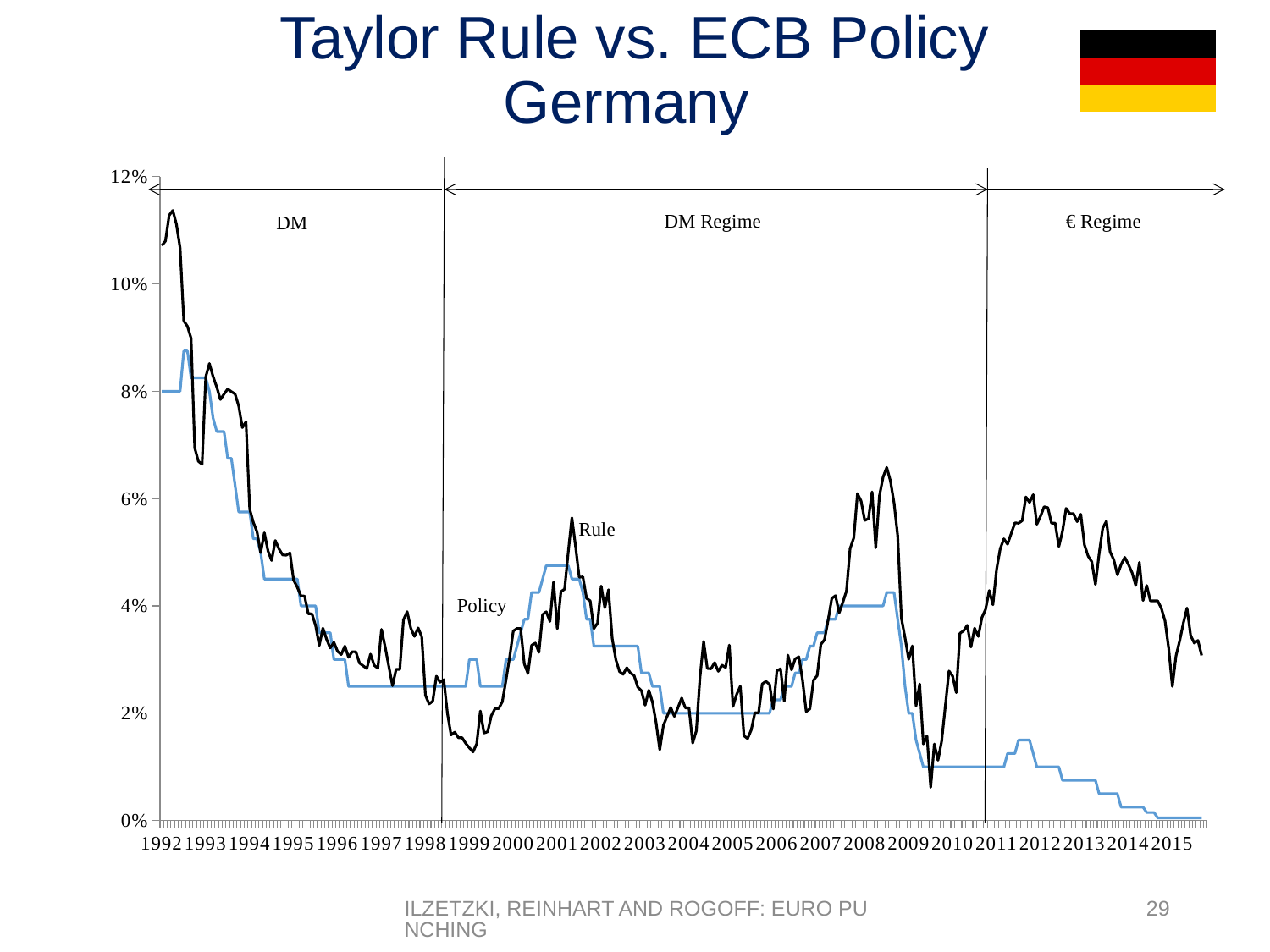
Is the Policy value in 2012 greater or less than 2%? less Is the Rule value in 2012 greater or less than 4%? greater In 2013, which series is higher, Rule or Policy? Rule What is the label of the regime period on the right-hand side of the chart? € Regime What kind of chart is shown on the slide? line chart Is the Policy value in 2015 greater or less than 2%? less Does the Rule series rise or fall between 1992 and 1998? fall Does the Policy series rise or fall between 2011 and 2015? fall How many series are plotted on the chart? 2 What are the names of the two series plotted on the chart? Rule and Policy